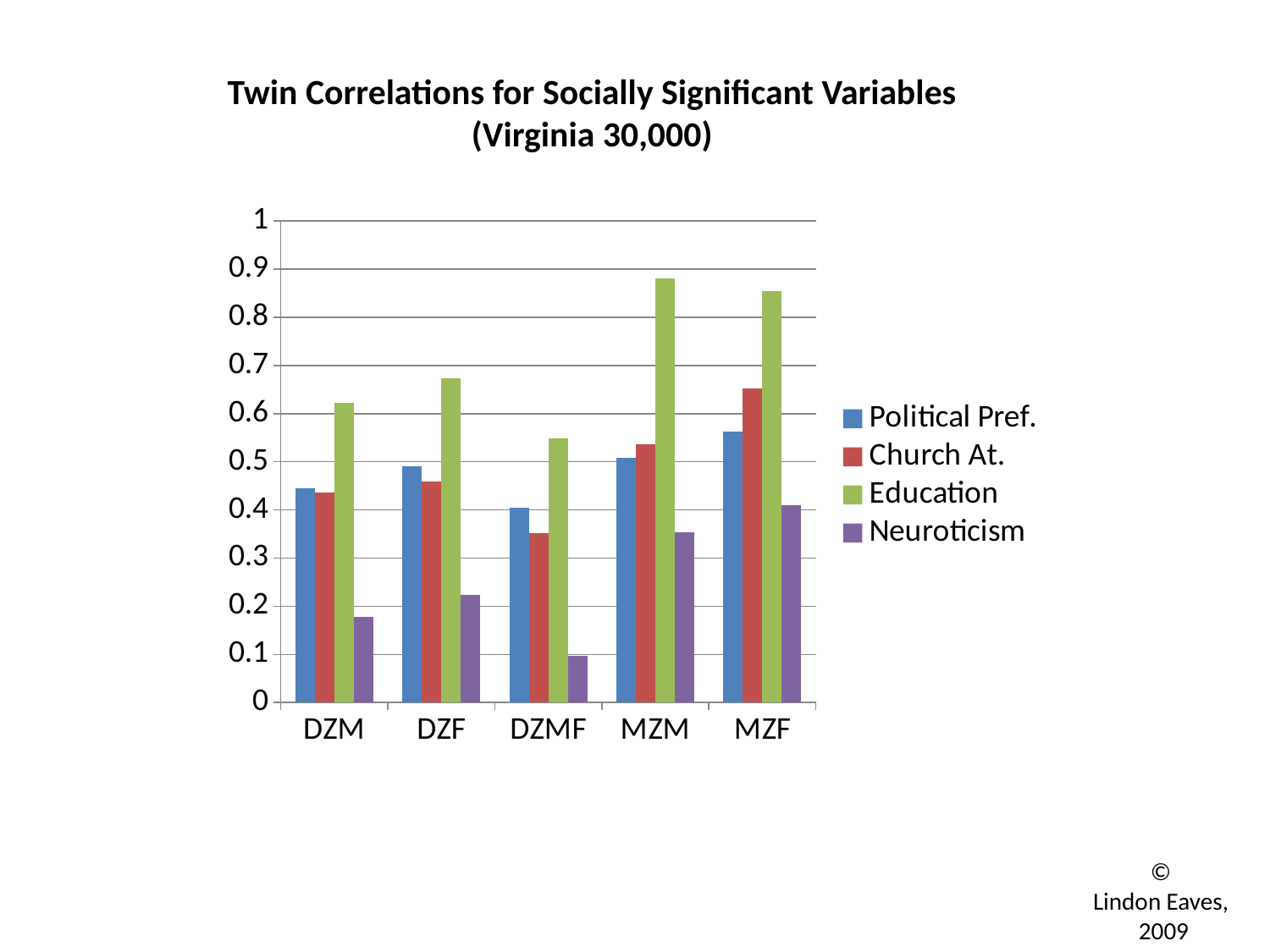
Is the Education value for MZM greater or less than 0.8? greater For MZF, which is larger: the Church At. value or the Political Pref. value? Church At. Is the Church At. value for MZF greater or less than 0.6? greater For DZM, which is larger: the Education value or the Neuroticism value? Education Which category has the highest Neuroticism correlation? MZF How many series does the legend list? 4 Which colour represents the Education series in the legend? Green Which category has the lowest Church At. correlation? DZMF What kind of chart is shown on the slide? Bar chart Which category has the lowest Neuroticism correlation? DZMF Is the Neuroticism value for DZMF greater or less than 0.2? less How many twin-group categories are shown on the x axis? 5